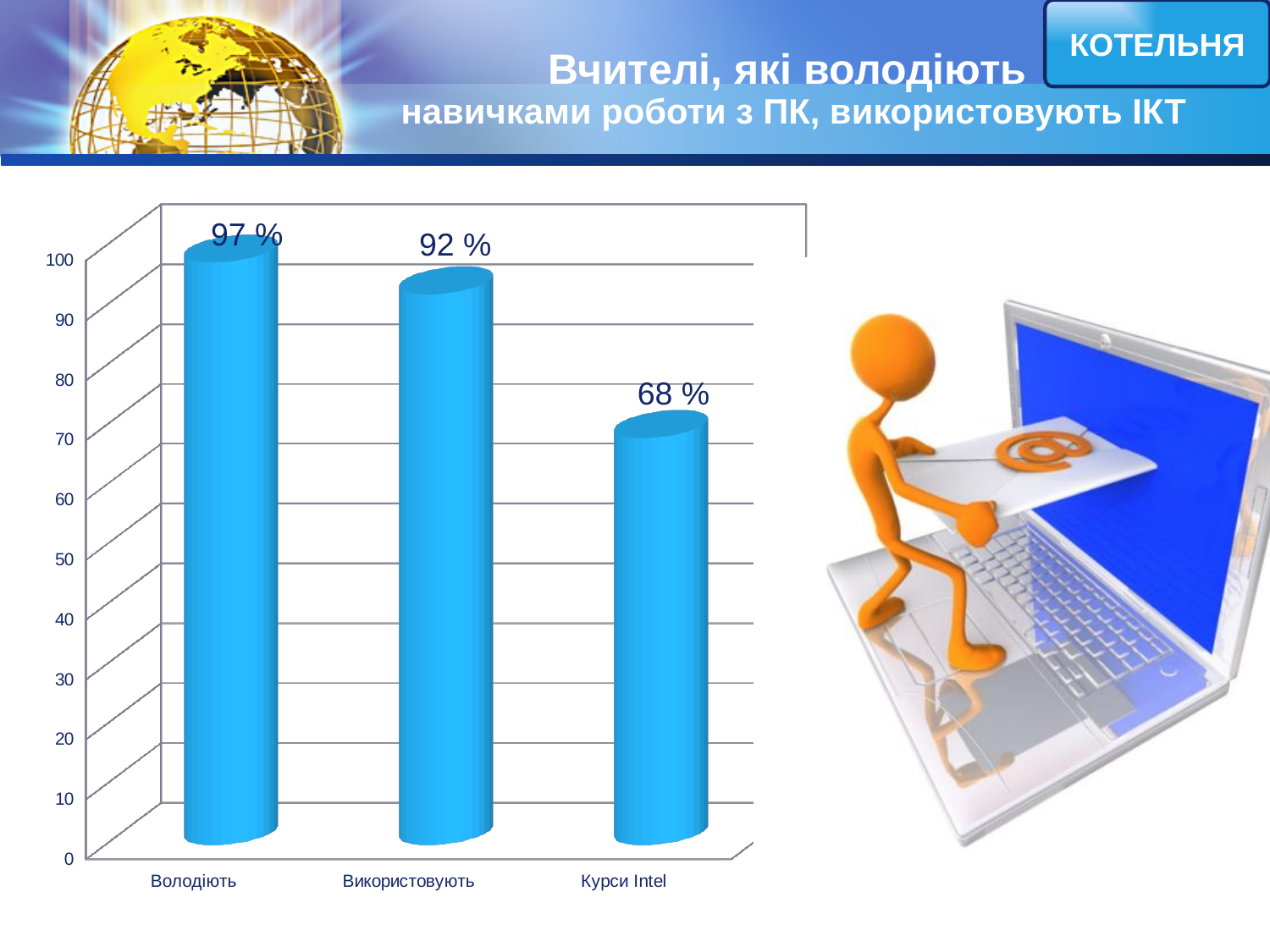
What is the difference between the values for Володіють and Курси Intel? 29 % Which category has the highest value? Володіють Which is larger, the value for Використовують or the value for Курси Intel? Використовують What kind of chart is shown on the slide? bar chart How many categories are shown in the chart? 3 What is the value for Володіють? 97 % Is the value for Курси Intel greater or less than 70? less What is the difference between the values for Використовують and Курси Intel? 24 % Do the values rise or fall from left to right across the categories? fall Which category has the lowest value? Курси Intel What is the value for Використовують? 92 % What is the value for Курси Intel? 68 %